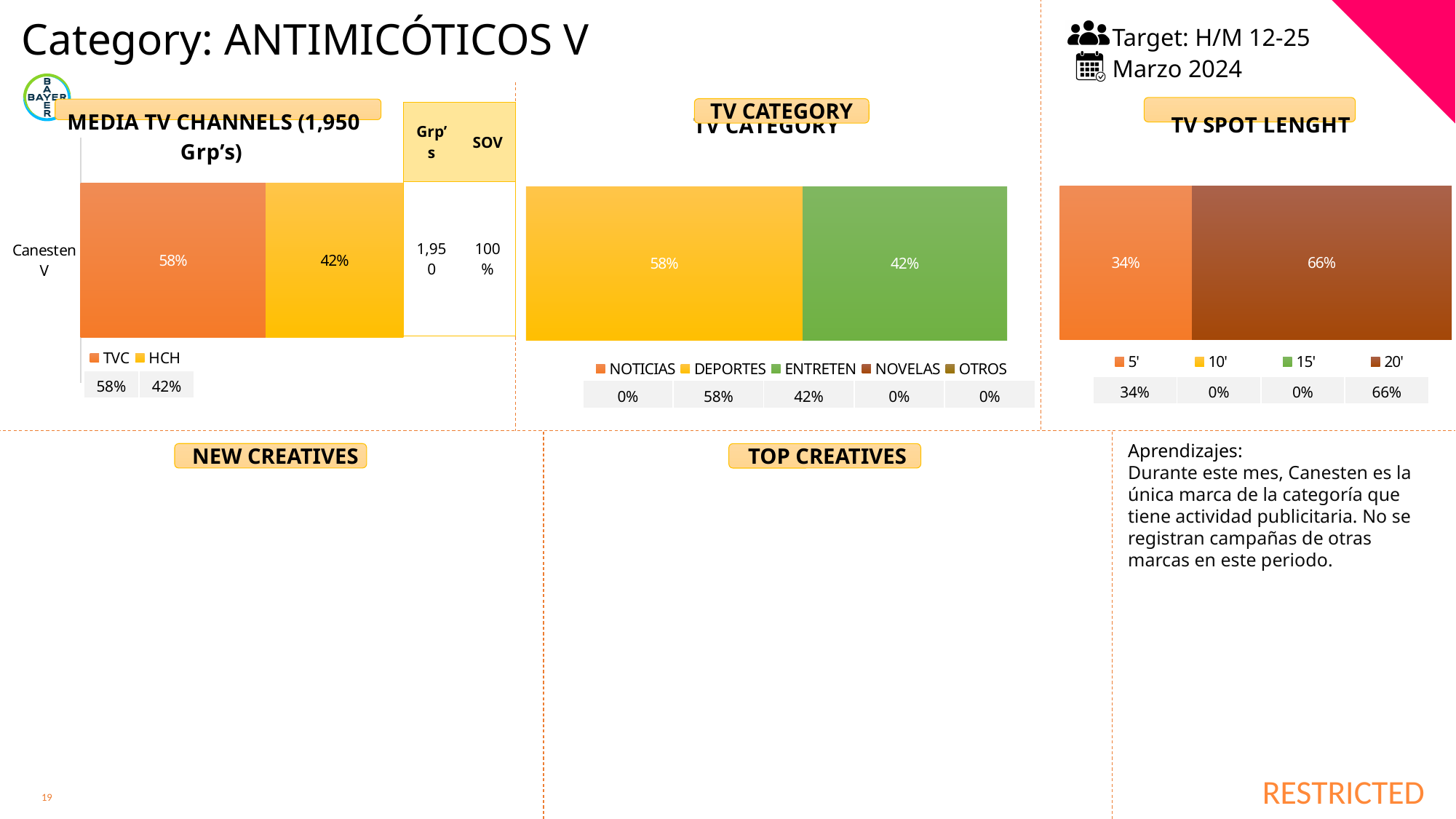
In the MEDIA TV CHANNELS chart, what share does TVC have for Canesten V? 58% In the TV CATEGORY chart, which category has the highest share? DEPORTES In the TV SPOT LENGHT chart, what share does the 5' spot length have? 34% In the TV CATEGORY chart, what share does DEPORTES have? 58% In the MEDIA TV CHANNELS chart, which channel has the larger share, TVC or HCH? TVC In the TV SPOT LENGHT chart, what share does the 20' spot length have? 66% What kind of chart is the TV SPOT LENGHT chart? Stacked bar chart In the TV CATEGORY chart, what share does ENTRETEN have? 42% How many series does the legend of the TV CATEGORY chart list? 5 In the MEDIA TV CHANNELS chart, what is the difference between the TVC and HCH shares? 16% In the TV SPOT LENGHT chart, what is the difference between the 20' and 5' shares? 32% In the MEDIA TV CHANNELS chart, what share does HCH have for Canesten V? 42%